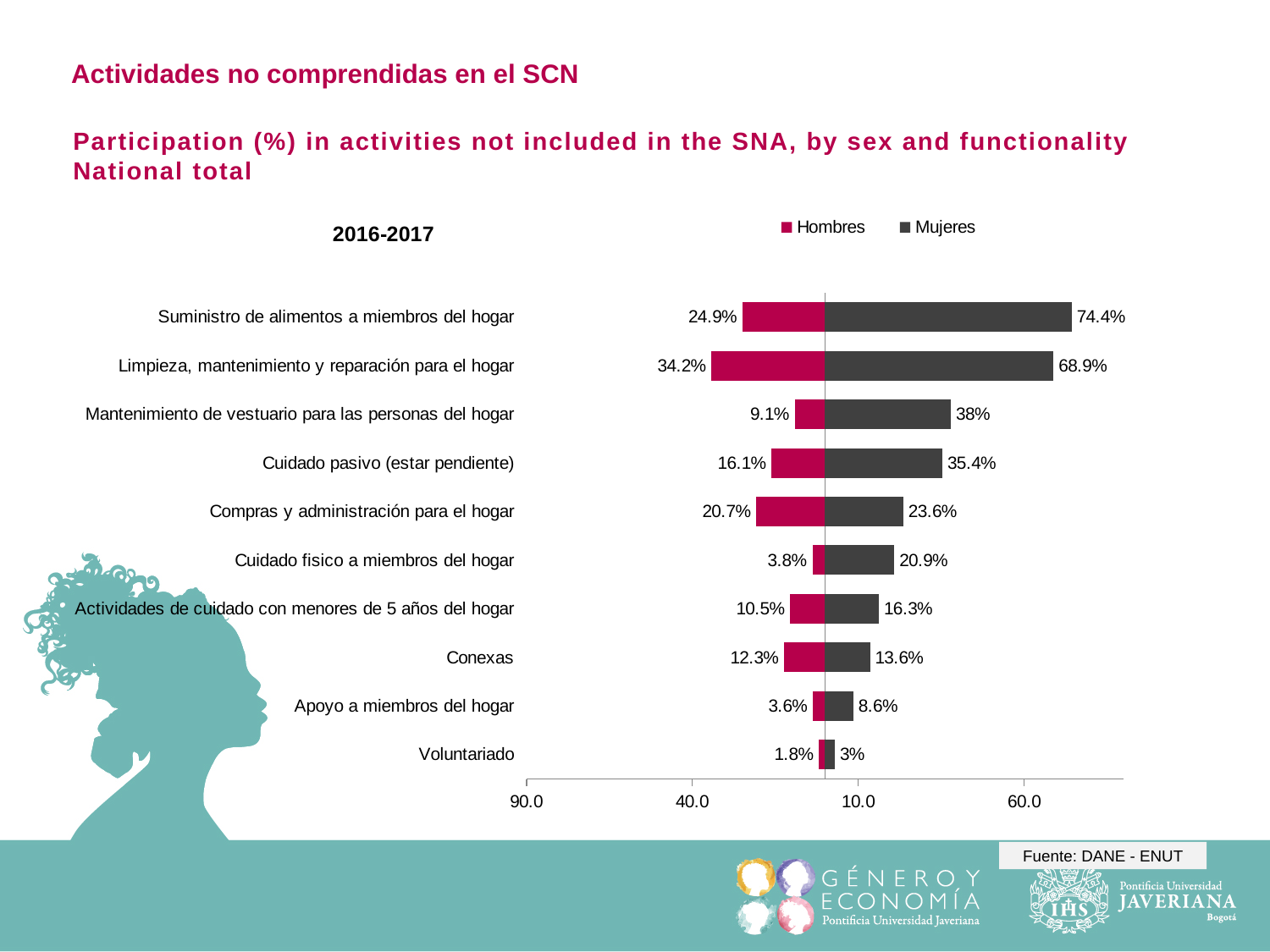
What kind of chart is shown on the slide? Bar chart Which is larger: the Hombres value for "Compras y administración para el hogar" or the Hombres value for "Cuidado pasivo (estar pendiente)"? Compras y administración para el hogar What is the value for Hombres in the category "Limpieza, mantenimiento y reparación para el hogar"? 34.2% How many categories are shown in the chart? 10 What is the value for Hombres in the category "Voluntariado"? 1.8% What is the value for Mujeres in the category "Mantenimiento de vestuario para las personas del hogar"? 38% What is the value for Mujeres in the category "Suministro de alimentos a miembros del hogar"? 74.4% Which category has the lowest value for Hombres? Voluntariado Which series is shown in pink in the chart? Hombres How many series does the legend list? 2 What is the difference between the Mujeres and Hombres values for "Cuidado pasivo (estar pendiente)"? 19.3 percentage points Which category has the highest value for Mujeres? Suministro de alimentos a miembros del hogar